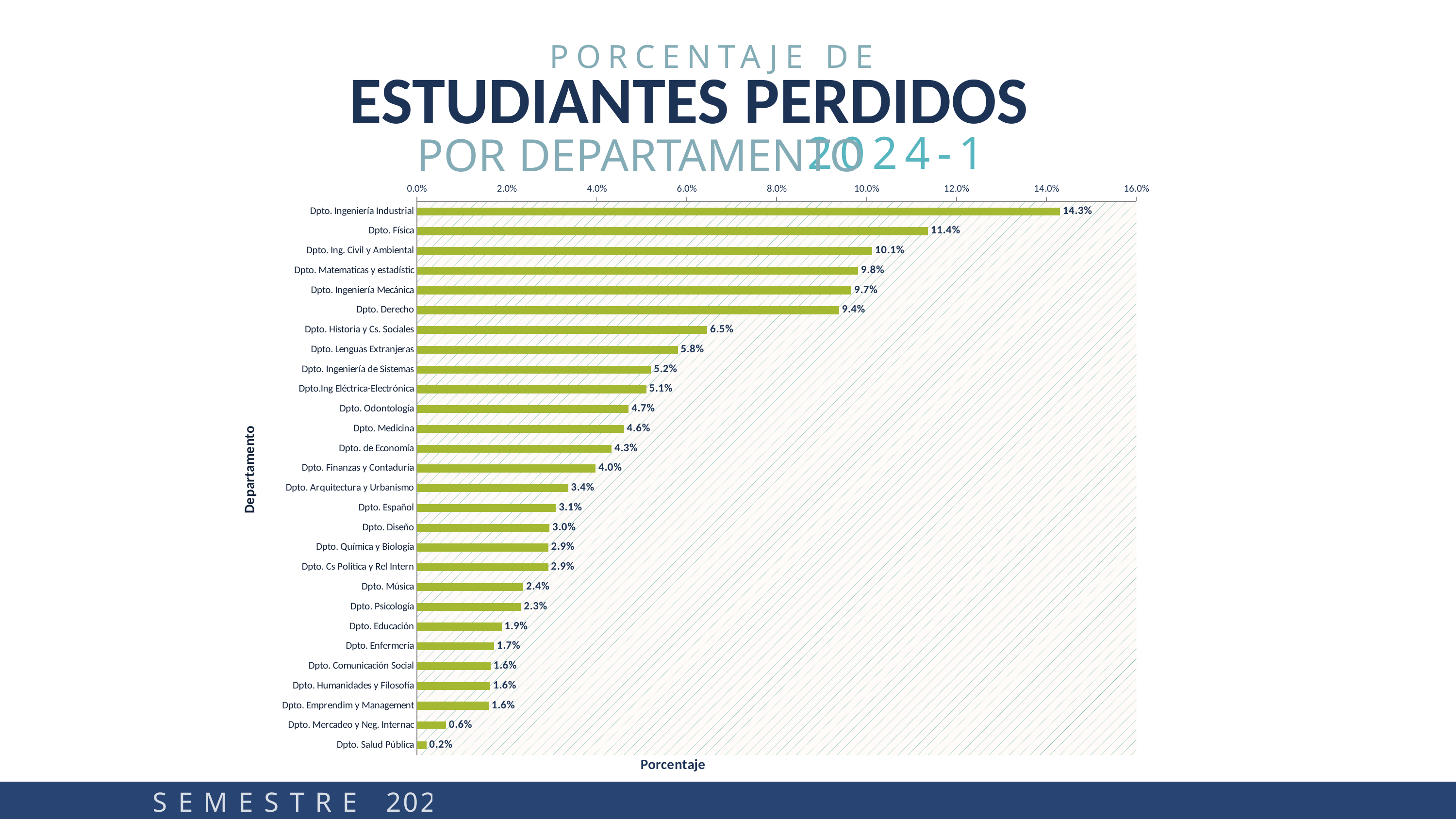
What is the label of the horizontal axis? Porcentaje What is the value for Dpto. Derecho? 9.4% Which department has the highest percentage? Dpto. Ingeniería Industrial What is the difference between the values for Dpto. Física and Dpto. Ing. Civil y Ambiental? 1.3% What kind of chart is shown on the slide? Bar chart What is the value for Dpto. Medicina? 4.6% Is the value for Dpto. Ingeniería Mecánica greater or less than 8.0%? greater Which is larger, the value for Dpto. Historia y Cs. Sociales or Dpto. Lenguas Extranjeras? Dpto. Historia y Cs. Sociales What is the value for Dpto. Psicología? 2.3% How many departments are shown in the chart? 28 Which department has the lowest percentage? Dpto. Salud Pública What is the value for Dpto. Ingeniería Industrial? 14.3%